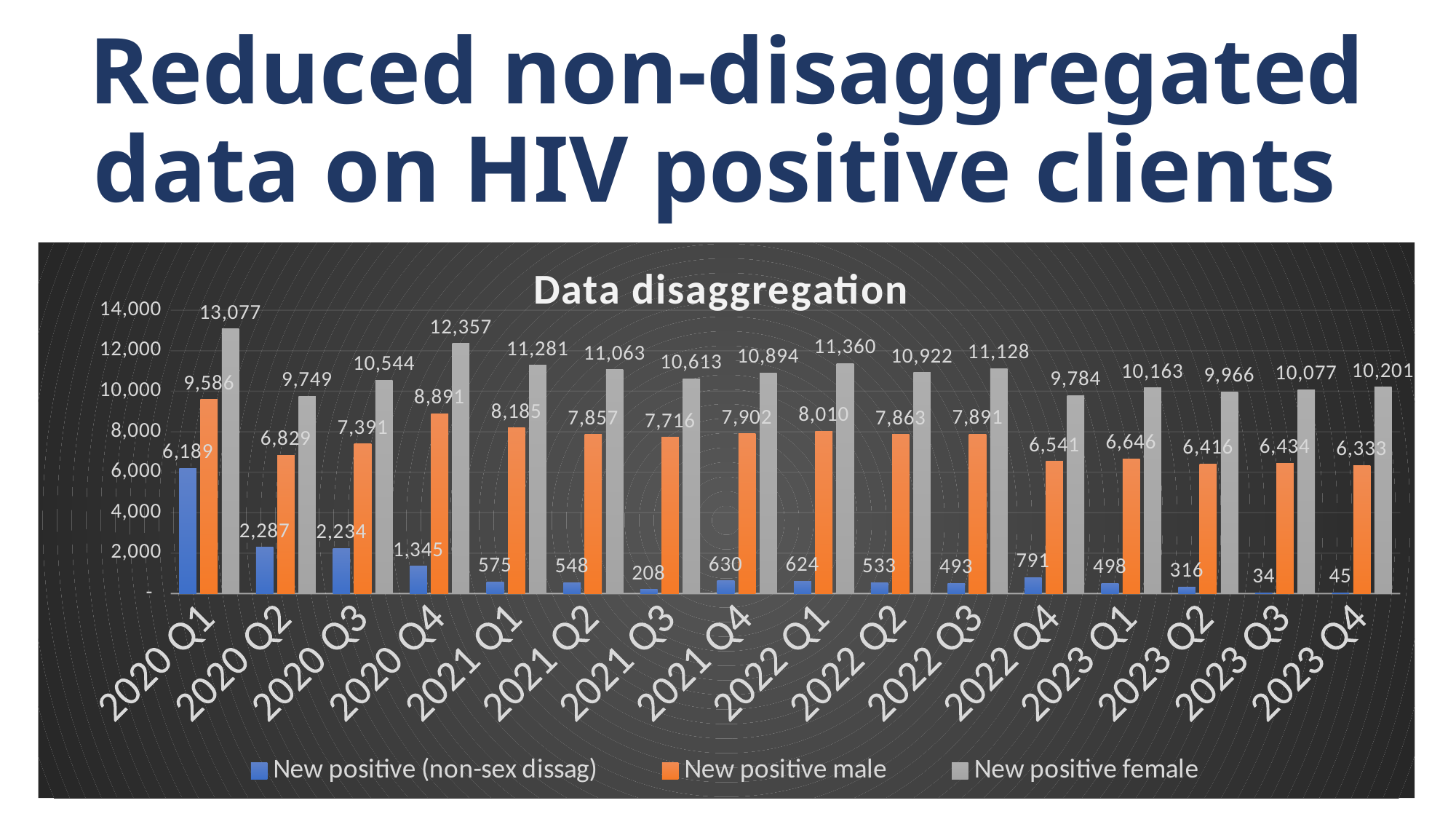
Does New positive (non-sex dissag) generally rise or fall from 2020 Q1 to 2023 Q4? Fall In which quarter is New positive female lowest? 2020 Q2 What type of chart is shown on the slide? Bar chart Which is larger: New positive male in 2020 Q4 or New positive male in 2021 Q1? 2020 Q4 What is the value of New positive (non-sex dissag) for 2023 Q3? 34 What is the value of New positive male for 2021 Q4? 7,902 What is the value of New positive female for 2020 Q1? 13,077 How many series does the legend list? 3 How many quarters are shown on the x axis? 16 In which quarter is New positive (non-sex dissag) highest? 2020 Q1 What is the chart title? Data disaggregation What is the difference between New positive female and New positive male in 2023 Q4? 3,868